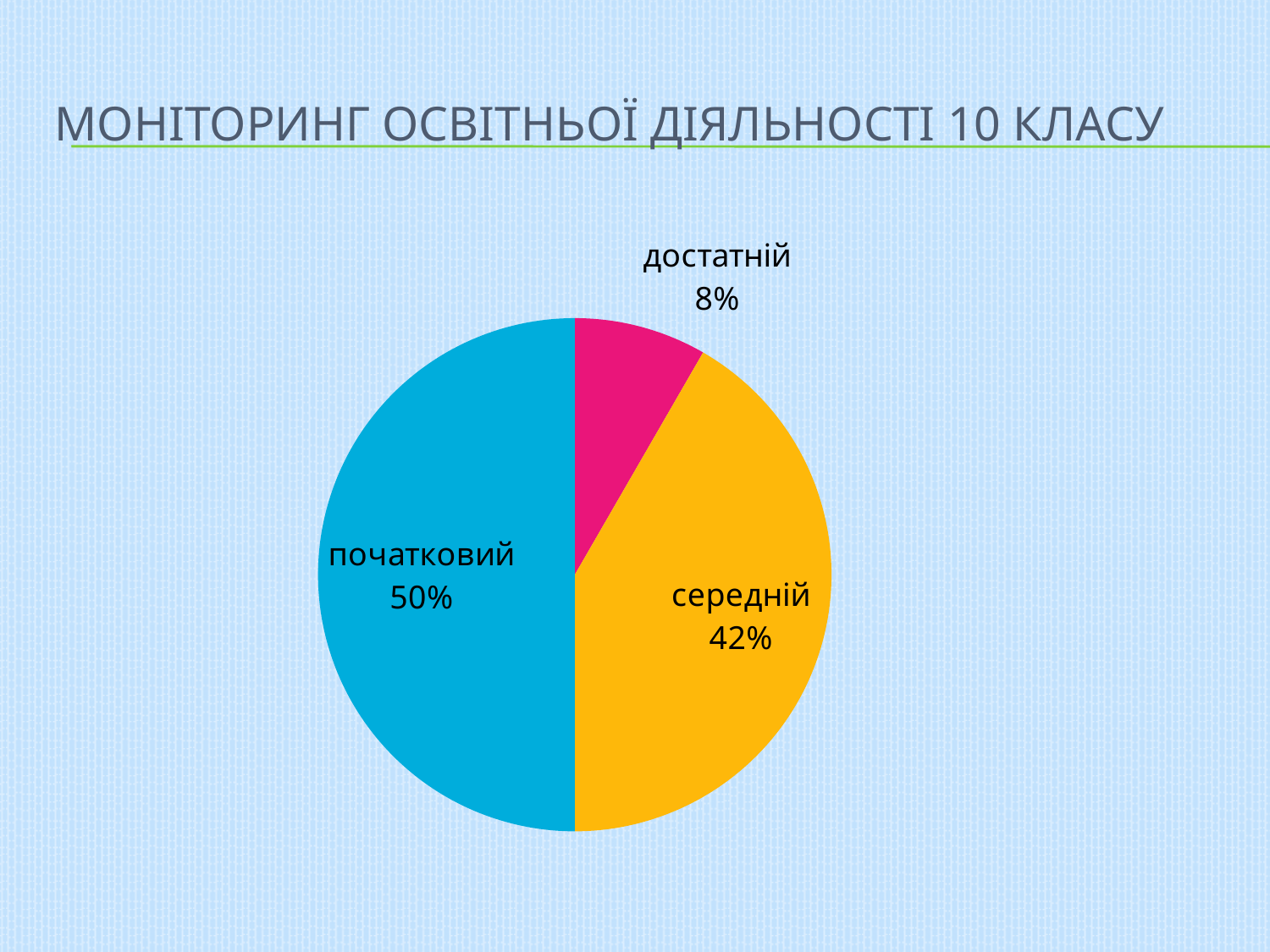
What is the difference in percentage points between the "середній" and "достатній" slices? 34% What share of the pie does the "достатній" slice represent? 8% What colour is the "достатній" slice? pink (magenta) What share of the pie does the "початковий" slice represent? 50% What kind of chart is shown on the slide? pie chart What is the title of the slide containing the chart? МОНІТОРИНГ ОСВІТНЬОЇ ДІЯЛЬНОСТІ 10 КЛАСУ Which category has the largest slice of the pie? початковий What share of the pie does the "середній" slice represent? 42% Which slice is larger, "середній" or "достатній"? середній Which category has the smallest slice of the pie? достатній How many slices does the pie chart have? 3 What is the difference in percentage points between the "початковий" and "середній" slices? 8%